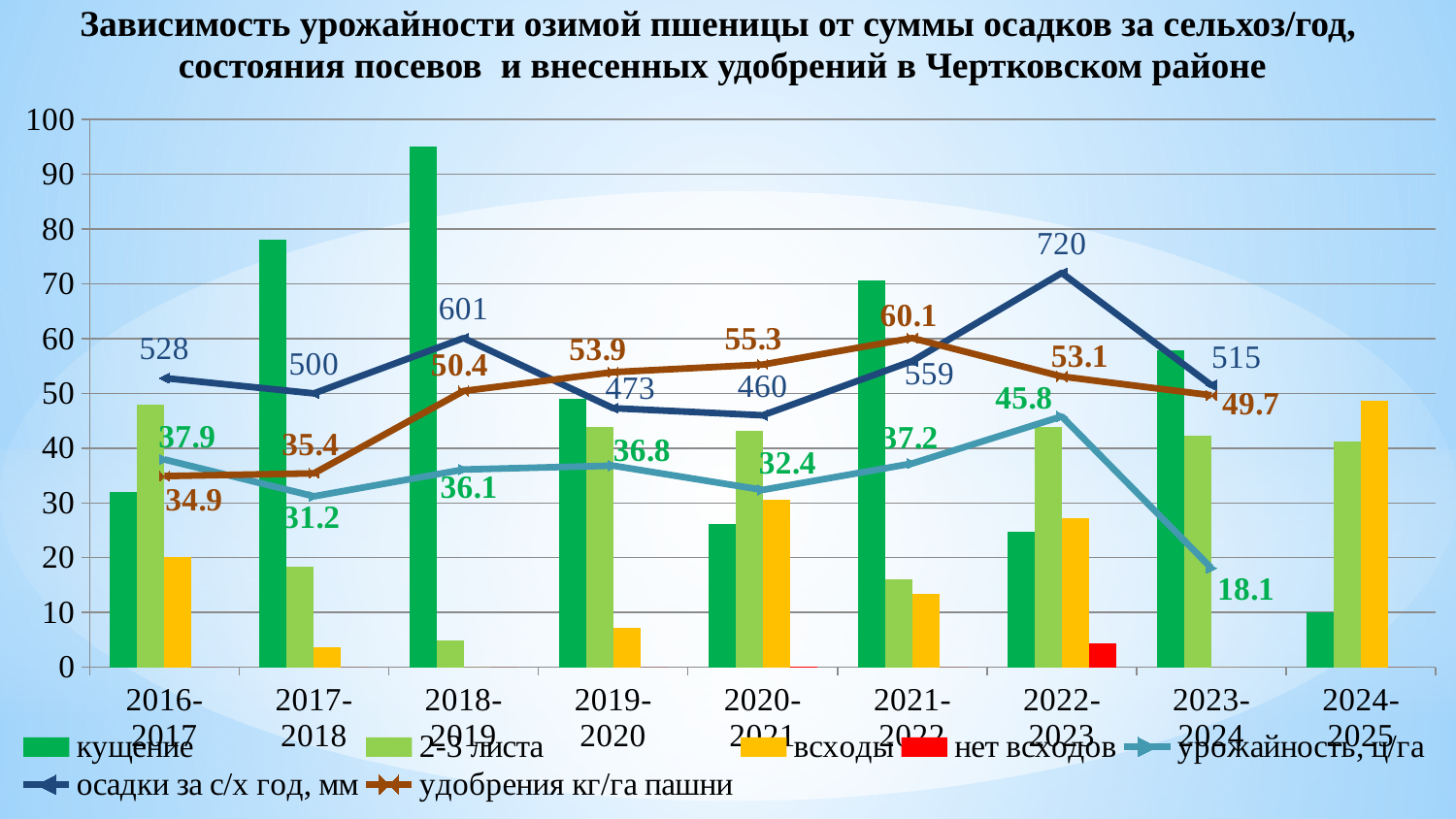
Which is larger: урожайность, ц/га in 2016-2017 or in 2017-2018? 2016-2017 What kind of chart is this? Combined bar and line chart Is the кущение bar for 2018-2019 greater or less than 90? greater What is the value of удобрения кг/га пашни for 2019-2020? 53.9 What is the difference between осадки за с/х год, мм in 2022-2023 and in 2023-2024? 205 In which season is осадки за с/х год, мм the highest? 2022-2023 How many seasons are shown on the x axis? 9 How many series does the legend list? 7 In which season is удобрения кг/га пашни the highest? 2021-2022 What is the value of осадки за с/х год, мм for 2022-2023? 720 In which season is урожайность, ц/га the lowest? 2023-2024 What is the value of урожайность, ц/га for 2023-2024? 18.1